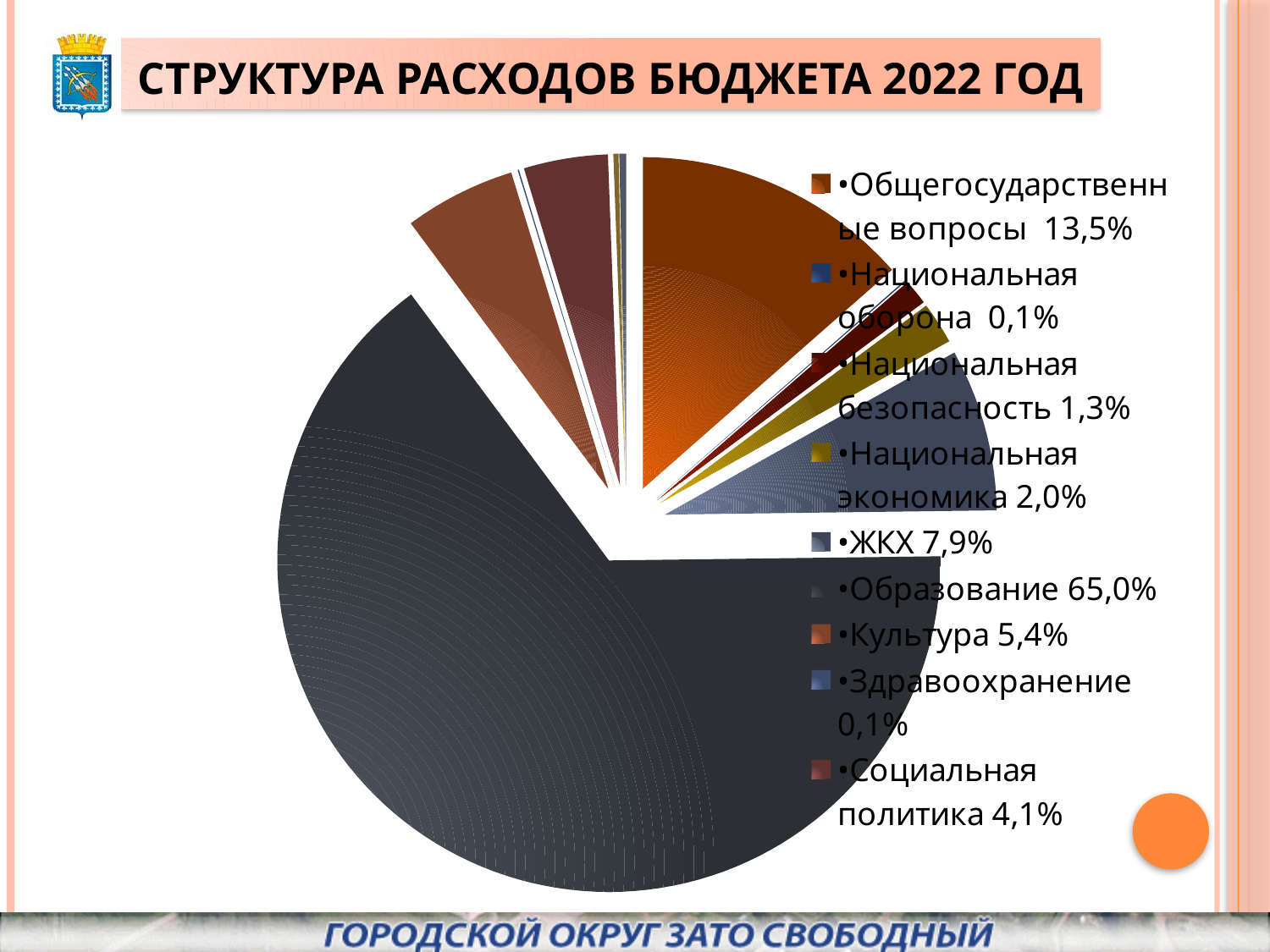
Which is larger, the share for Культура or the share for Социальная политика? Культура What is the value shown for Национальная экономика? 2,0% What is the difference between the shares for Образование and Общегосударственные вопросы? 51,5% How many categories does the pie chart legend list? 9 What is the value shown for Социальная политика? 4,1% Which category has the largest share of the pie? Образование What kind of chart is shown on the slide? pie chart What share of the budget expenditure goes to Образование? 65,0% What is the title of the chart on the slide? СТРУКТУРА РАСХОДОВ БЮДЖЕТА 2022 ГОД What is the value shown for ЖКХ? 7,9% What is the difference between the shares for Общегосударственные вопросы and ЖКХ? 5,6% What is the value shown for Общегосударственные вопросы? 13,5%